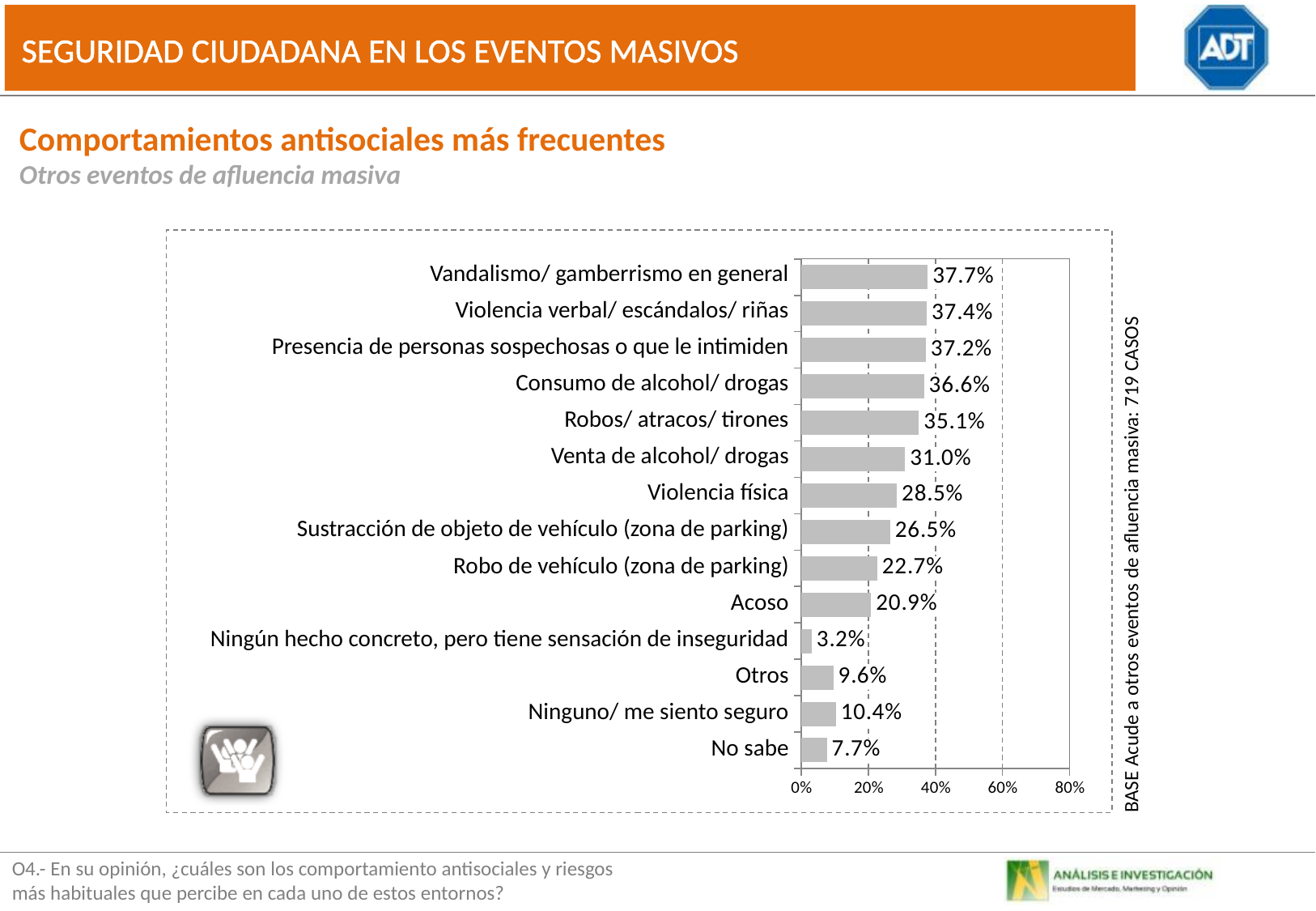
What is the value for Acoso? 20.9% Which category has the highest value? Vandalismo/ gamberrismo en general What is the value for Venta de alcohol/ drogas? 31.0% What is the value for No sabe? 7.7% Which is larger, Otros or Ninguno/ me siento seguro? Ninguno/ me siento seguro What is the value for Vandalismo/ gamberrismo en general? 37.7% What is the base (number of cases) stated beside the chart? 719 CASOS What is the difference between Robos/ atracos/ tirones and Violencia física? 6.6% Is the value for Robo de vehículo (zona de parking) greater or less than 20%? greater How many categories are shown in the chart? 14 Which category has the lowest value? Ningún hecho concreto, pero tiene sensación de inseguridad What kind of chart is shown on the slide? Bar chart